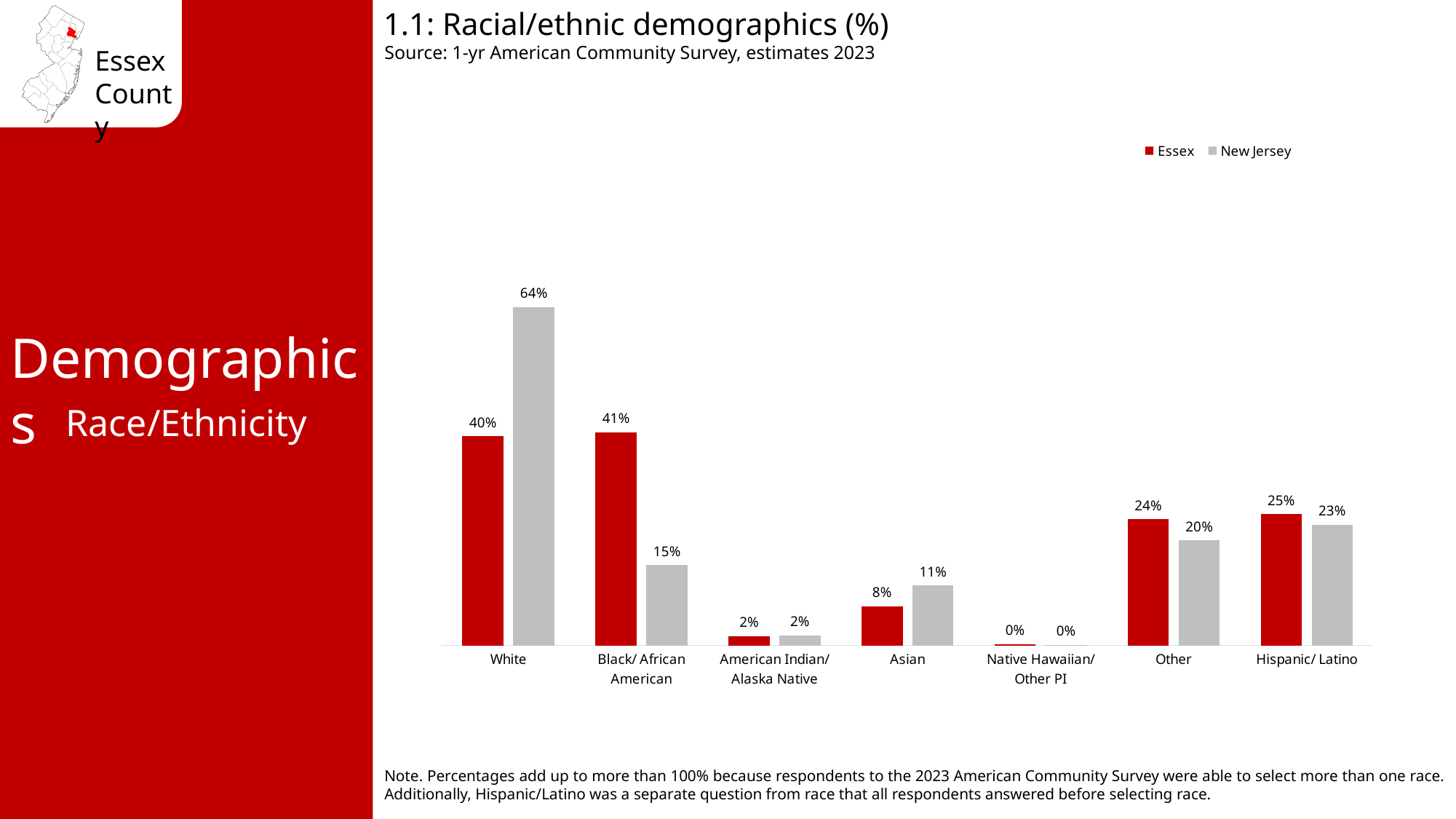
What is the Essex value for White? 40% Which category has the highest Essex value? Black/ African American Which is larger for Asian, the Essex value or the New Jersey value? New Jersey What is the New Jersey value for Asian? 11% How many series does the legend list? 2 What is the difference between the New Jersey and Essex values for White? 24% What is the New Jersey value for Black/ African American? 15% How many racial/ethnic categories are shown on the x axis? 7 What is the Essex value for Hispanic/ Latino? 25% Which category has the highest New Jersey value? White What is the difference between the Essex and New Jersey values for Black/ African American? 26% What kind of chart is shown? Bar chart